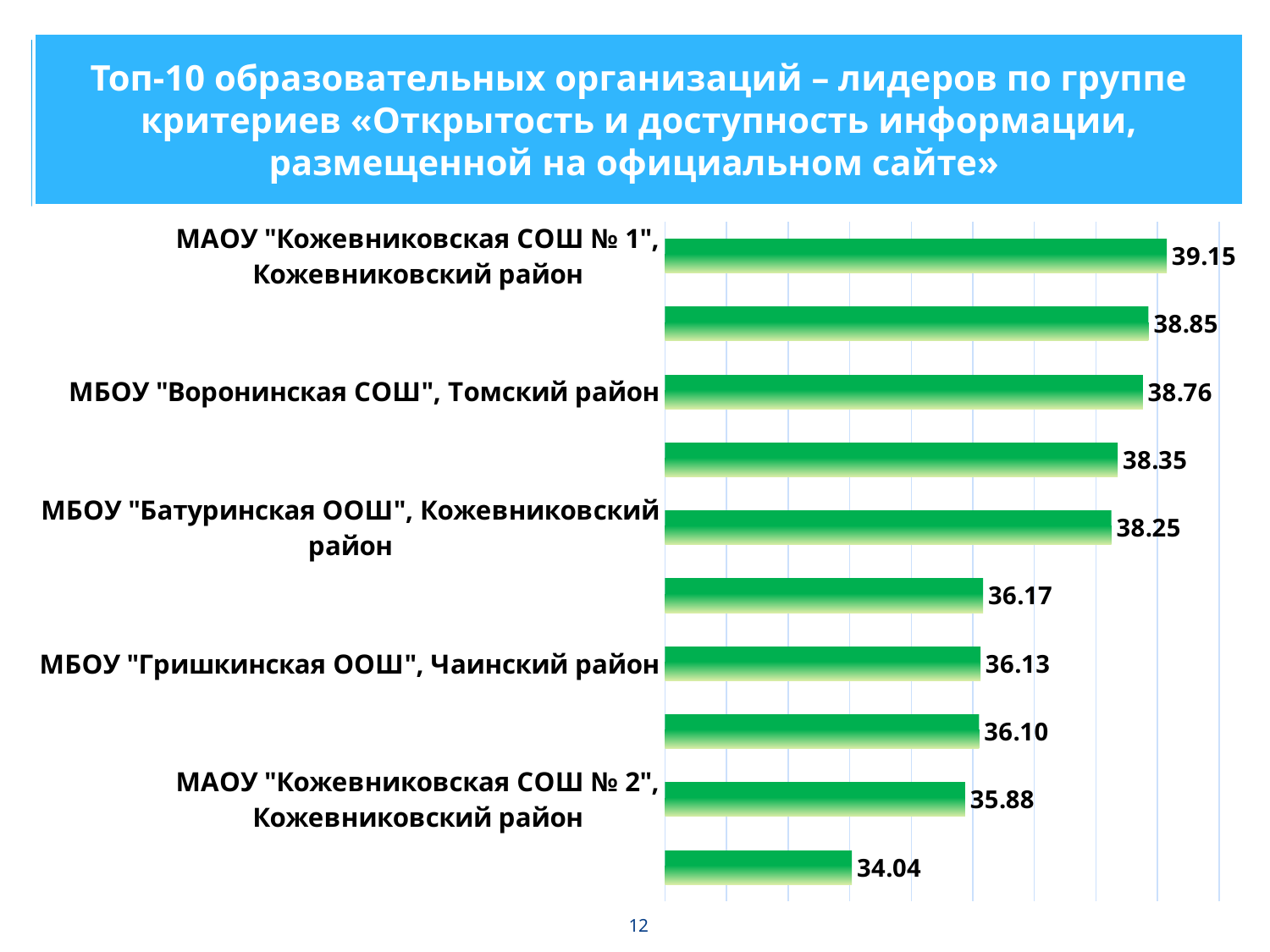
How many bars are plotted in the chart? 10 What is the lowest value shown in the chart? 34.04 Which organisation has the highest value in the chart? МАОУ "Кожевниковская СОШ № 1", Кожевниковский район What is the difference between the values for МАОУ "Кожевниковская СОШ № 1" and МАОУ "Кожевниковская СОШ № 2"? 3.27 What value is shown for МАОУ "Кожевниковская СОШ № 2", Кожевниковский район? 35.88 What value is shown for МБОУ "Гришкинская ООШ", Чаинский район? 36.13 What value is shown for МБОУ "Воронинская СОШ", Томский район? 38.76 What value is shown for МАОУ "Кожевниковская СОШ № 1", Кожевниковский район? 39.15 What kind of chart is shown on the slide? Bar chart Do the bar values increase or decrease from the top of the chart to the bottom? Decrease What value is shown for МБОУ "Батуринская ООШ", Кожевниковский район? 38.25 Which has the larger value: МБОУ "Воронинская СОШ", Томский район or МБОУ "Батуринская ООШ", Кожевниковский район? МБОУ "Воронинская СОШ", Томский район